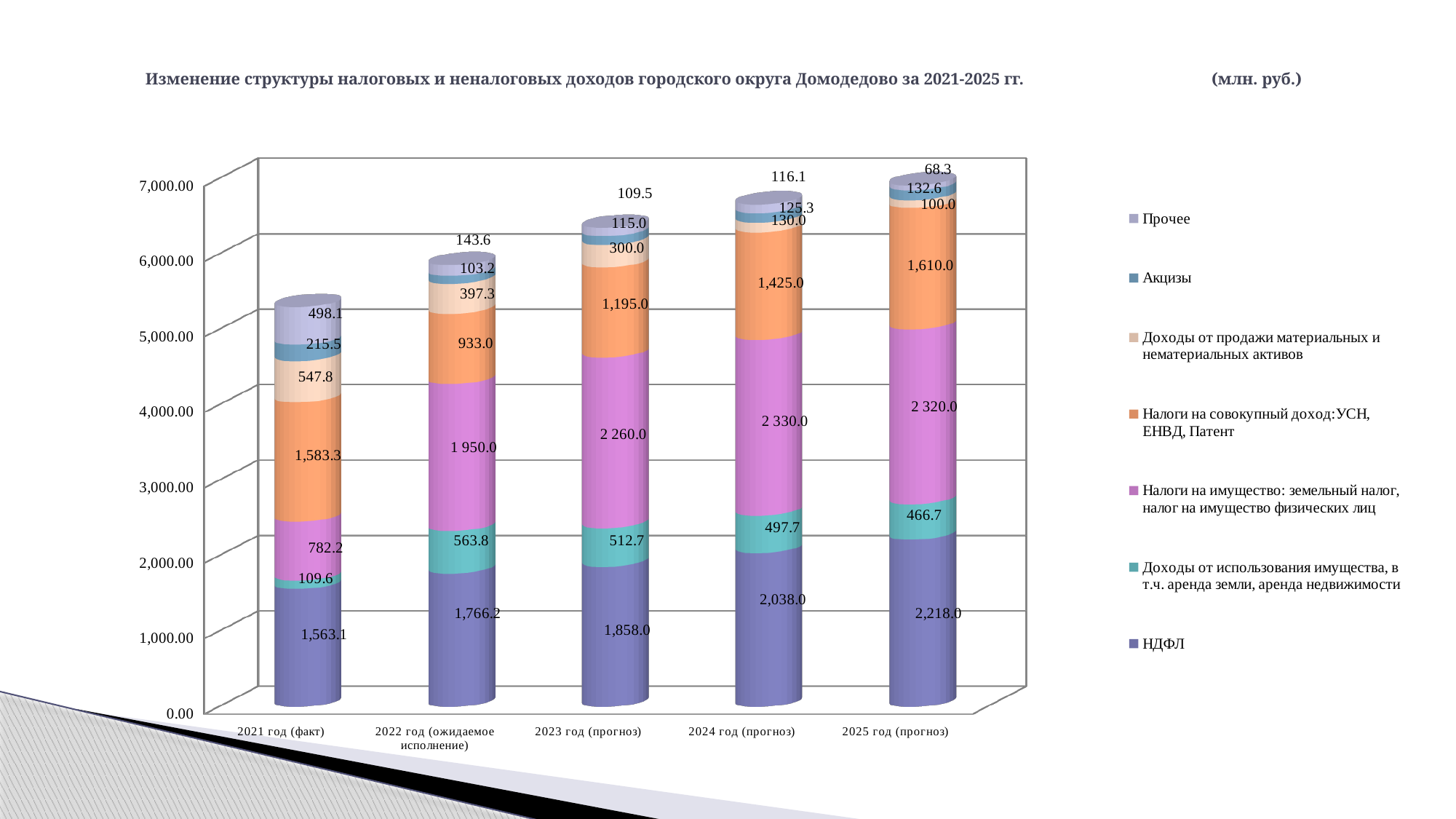
What is the value of Акцизы for 2024 год (прогноз)? 125.3 In which year is the НДФЛ value the highest? 2025 год (прогноз) How many series does the legend list? 7 What is the difference between the НДФЛ value for 2025 год (прогноз) and for 2021 год (факт)? 654.9 What is the value of Прочее for 2025 год (прогноз)? 68.3 Does the НДФЛ value rise or fall from 2021 to 2025? Rises How many years (categories) are shown on the x axis? 5 What is the value of НДФЛ for 2021 год (факт)? 1,563.1 What is the value of Налоги на имущество: земельный налог, налог на имущество физических лиц for 2023 год (прогноз)? 2 260.0 Which year has the larger value for Налоги на совокупный доход: УСН, ЕНВД, Патент, 2021 год (факт) or 2022 год (ожидаемое исполнение)? 2021 год (факт) What kind of chart is shown on the slide? Stacked bar chart In which year is the Прочее value the lowest? 2025 год (прогноз)